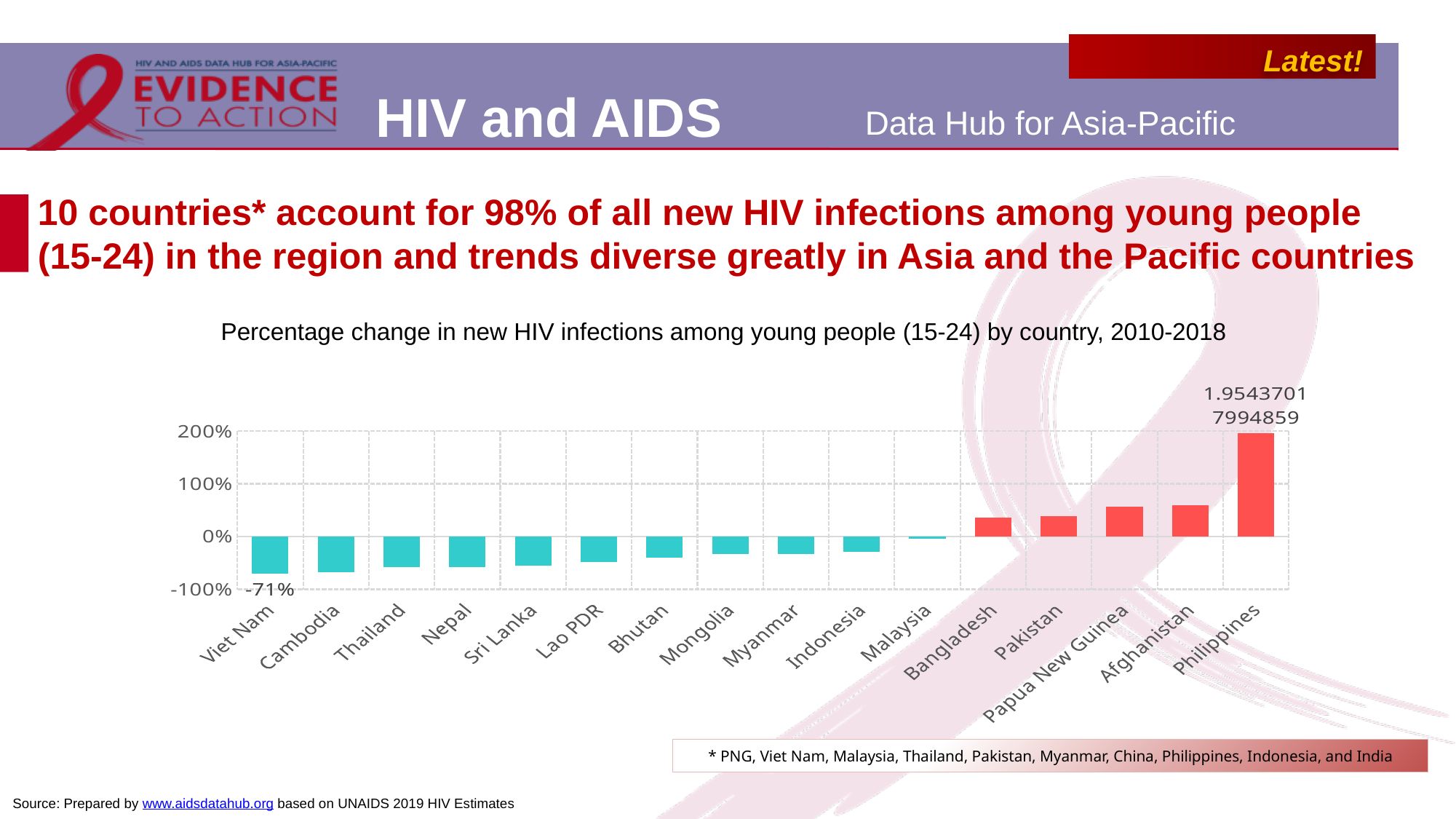
What kind of chart is shown on the slide? bar chart Which country has the lowest percentage change in new HIV infections among young people? Viet Nam Do the values generally rise or fall moving from left to right along the x axis? rise What is the title of the chart? Percentage change in new HIV infections among young people (15-24) by country, 2010-2018 How many countries have bars coloured red (positive change) in the chart? 5 How many countries are shown on the x axis of the chart? 16 What is the percentage change in new HIV infections among young people for Viet Nam? -71% Which country has the highest percentage change in new HIV infections among young people? Philippines Which has a larger percentage change, Philippines or Afghanistan? Philippines Is the value for Philippines greater or less than 100%? greater Is the value for Thailand greater or less than 0%? less Is the value for Bangladesh greater or less than 100%? less